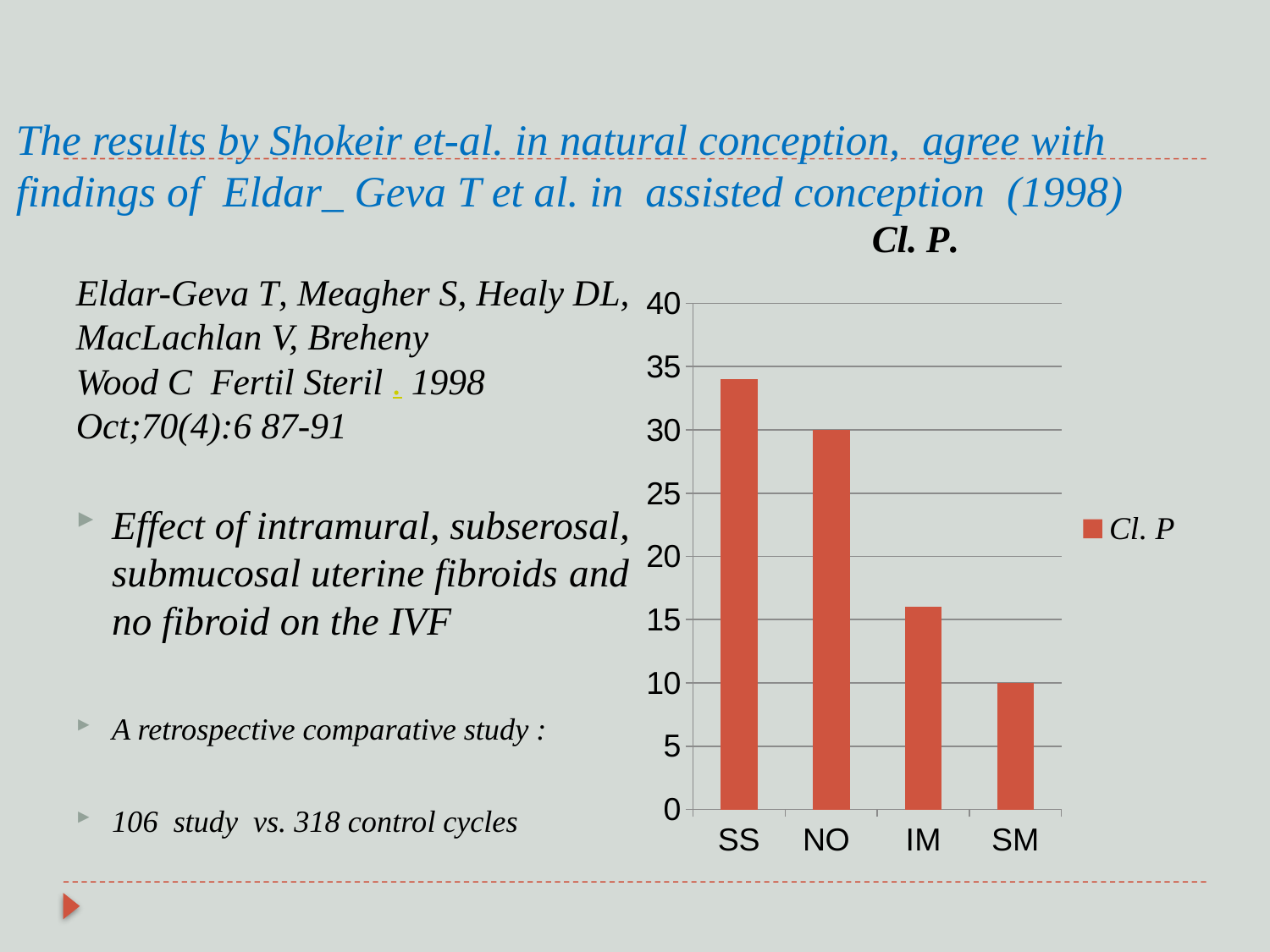
What type of chart is shown on the slide? bar chart What is the value for SM in the chart? 10 Which category has the highest value in the chart? SS How many categories are shown on the x axis of the chart? 4 How many series does the chart legend list? 1 Is the value for IM greater or less than 20? less Which category has the lowest value in the chart? SM What is the difference between the values for NO and SM? 20 What is the value for NO in the chart? 30 Is the value for SS greater or less than 30? greater What is the title of the chart? Cl. P. Do the values rise or fall from SS to SM along the x axis? fall